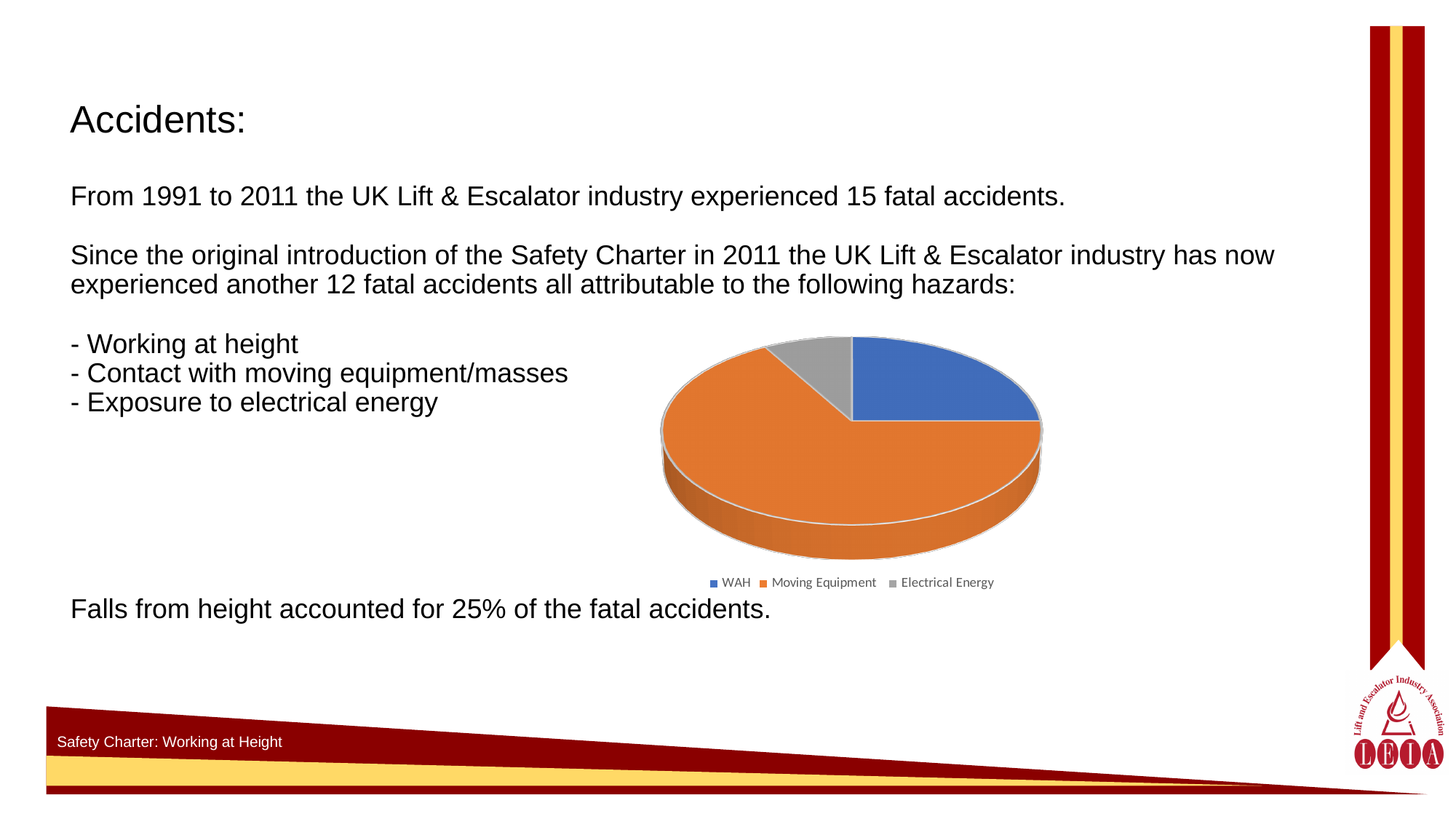
Which category is shown in grey in the pie chart? Electrical Energy Which category has the largest slice of the pie chart? Moving Equipment Which category has the smallest slice of the pie chart? Electrical Energy Which slice is larger in the pie chart, Moving Equipment or WAH? Moving Equipment What kind of chart is shown on the slide? Pie chart How many slices does the pie chart have? 3 Which slice is larger in the pie chart, Moving Equipment or Electrical Energy? Moving Equipment What colour is the WAH slice in the pie chart? Blue How many entries does the pie chart's legend list? 3 Which slice is larger in the pie chart, WAH or Electrical Energy? WAH